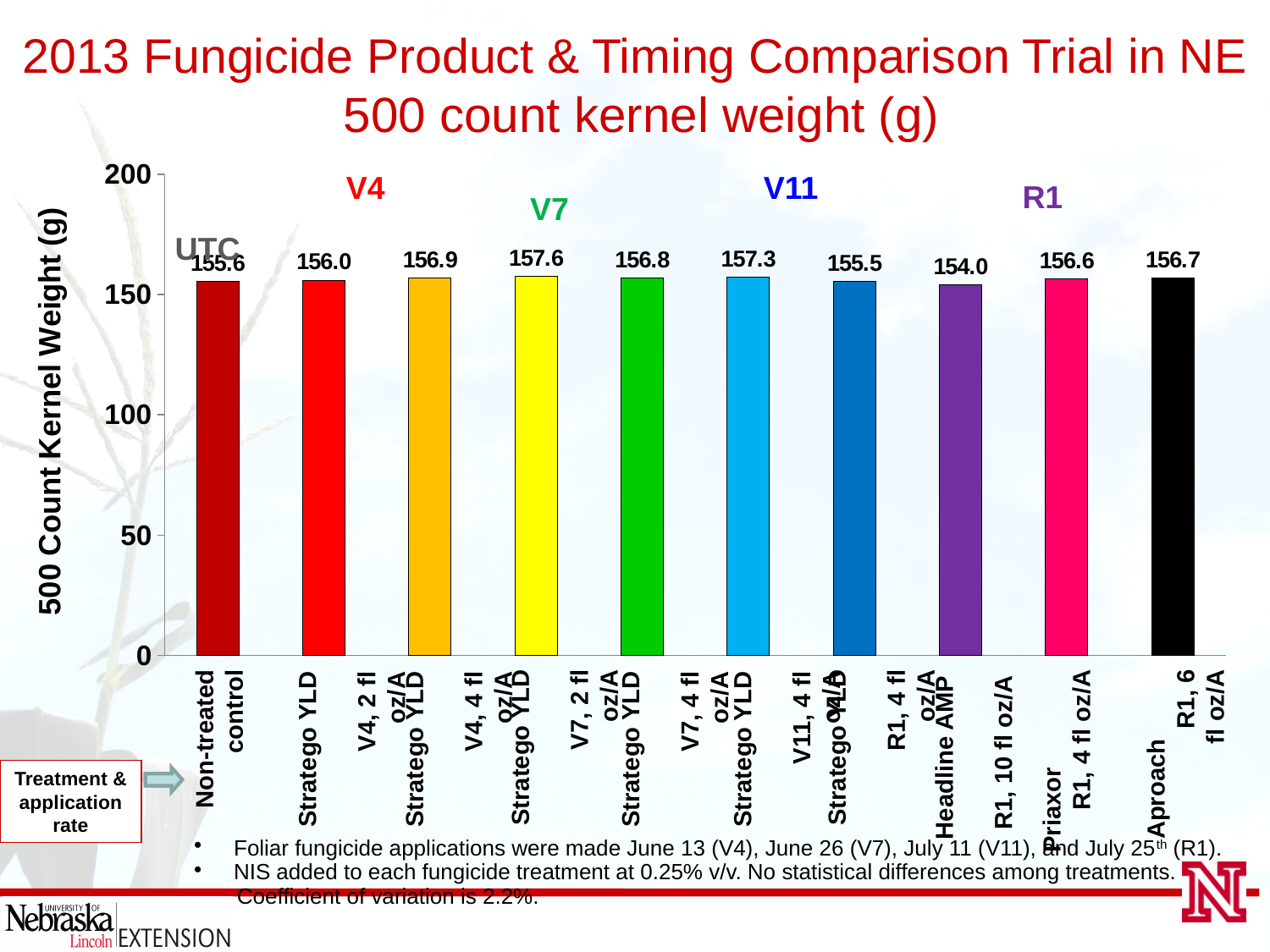
What is the value shown for Aproach at R1, 6 fl oz/A? 156.7 What is the label on the vertical axis of the chart? 500 Count Kernel Weight (g) Which treatment has the lowest 500 count kernel weight? Headline AMP R1, 10 fl oz/A (154.0) Is the value for the Non-treated control greater or less than 150? greater Which is larger: the value for Priaxor R1, 4 fl oz/A or the value for Stratego YLD R1, 4 fl oz/A? Priaxor R1, 4 fl oz/A (156.6) What type of chart is shown on the slide? Bar chart What is the 500 count kernel weight for the Non-treated control? 155.6 What is the value shown for Stratego YLD at V11, 4 fl oz/A? 157.3 What is the value shown for Headline AMP at R1, 10 fl oz/A? 154.0 How many treatment bars are shown in the chart? 10 What is the difference between the highest value (157.6) and the lowest value (154.0)? 3.6 Which treatment has the highest 500 count kernel weight? Stratego YLD V7, 2 fl oz/A (157.6)